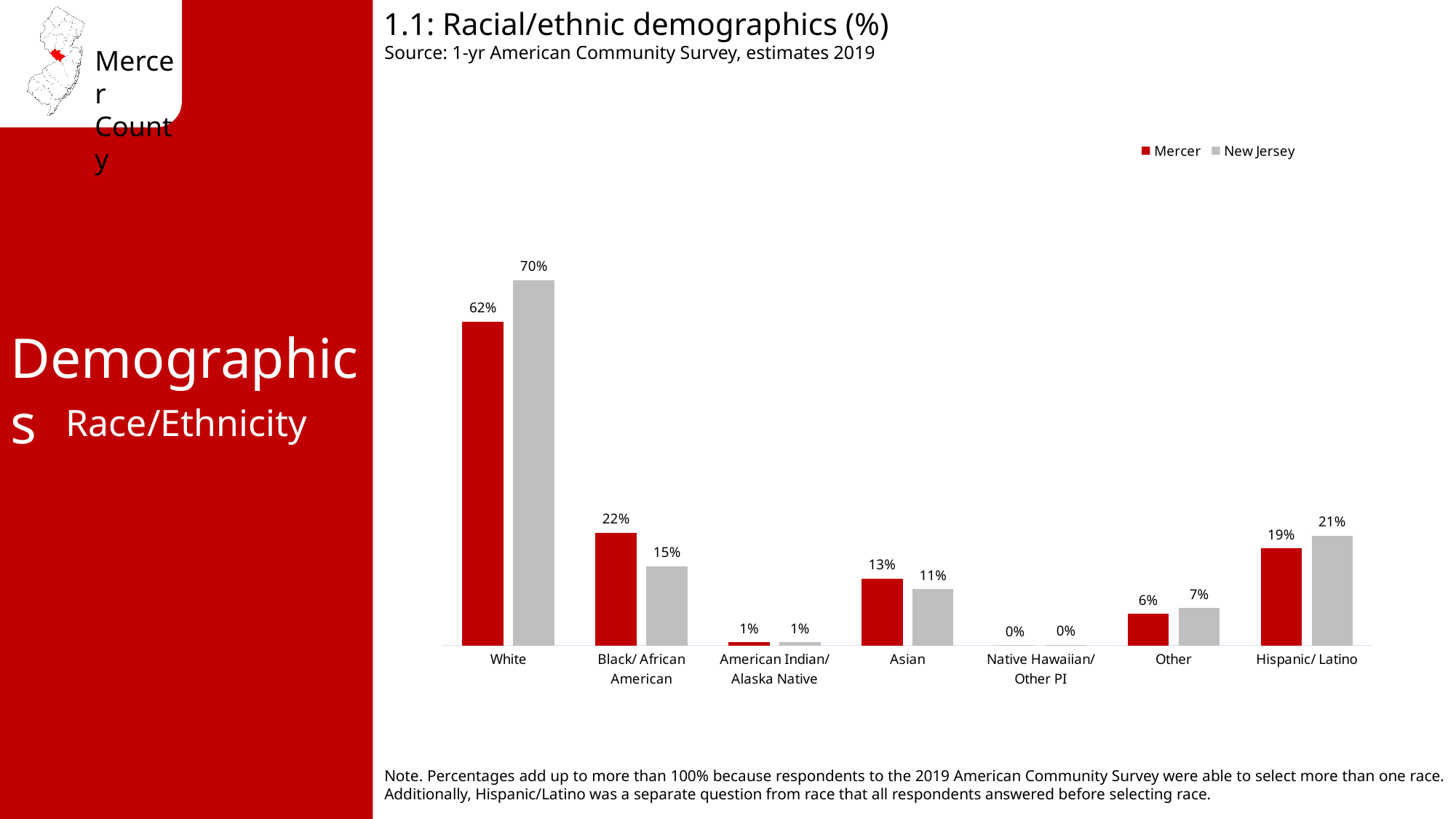
What is the New Jersey value for Black/ African American? 15% Which category has the lowest New Jersey value? Native Hawaiian/ Other PI Which category has the highest Mercer value? White What is the New Jersey value for Asian? 11% How many categories are shown on the x axis? 7 How many series does the legend list? 2 What is the title of the chart? 1.1: Racial/ethnic demographics (%) What kind of chart is shown? Bar chart What is the Mercer value for Hispanic/ Latino? 19% What is the difference between the New Jersey and Mercer values for White? 8% What is the Mercer value for White? 62% Which is larger for Black/ African American, the Mercer value or the New Jersey value? Mercer